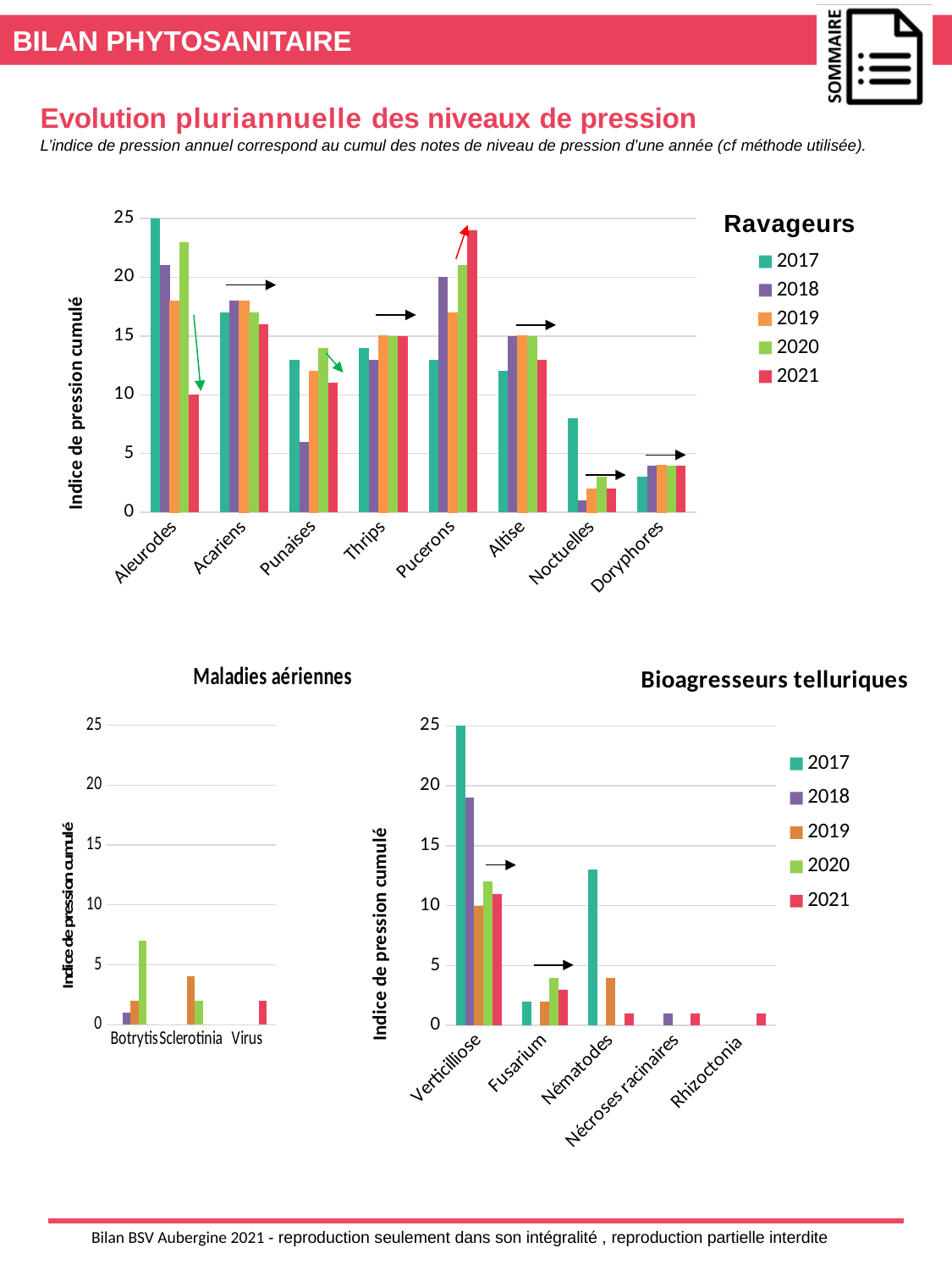
In the 'Ravageurs' chart, which category has the lowest 2021 bar? Noctuelles In the 'Bioagresseurs telluriques' chart, which is larger for Verticilliose: the 2018 value or the 2021 value? 2018 How many categories are shown on the x axis of the 'Maladies aériennes' chart? 3 In the 'Ravageurs' chart, which category has the highest 2017 bar? Aleurodes How many series does the legend of the 'Ravageurs' chart list? 5 How many categories are shown on the x axis of the 'Bioagresseurs telluriques' chart? 5 What kind of chart is the 'Ravageurs' chart? Bar chart How many categories are shown on the x axis of the 'Ravageurs' chart? 8 In the 'Ravageurs' chart, is the value for Pucerons in 2021 greater or less than 20? greater In the 'Ravageurs' chart, what is the value for Aleurodes in 2017? 25 In the 'Ravageurs' chart, is the value for Noctuelles in 2017 greater or less than 5? greater